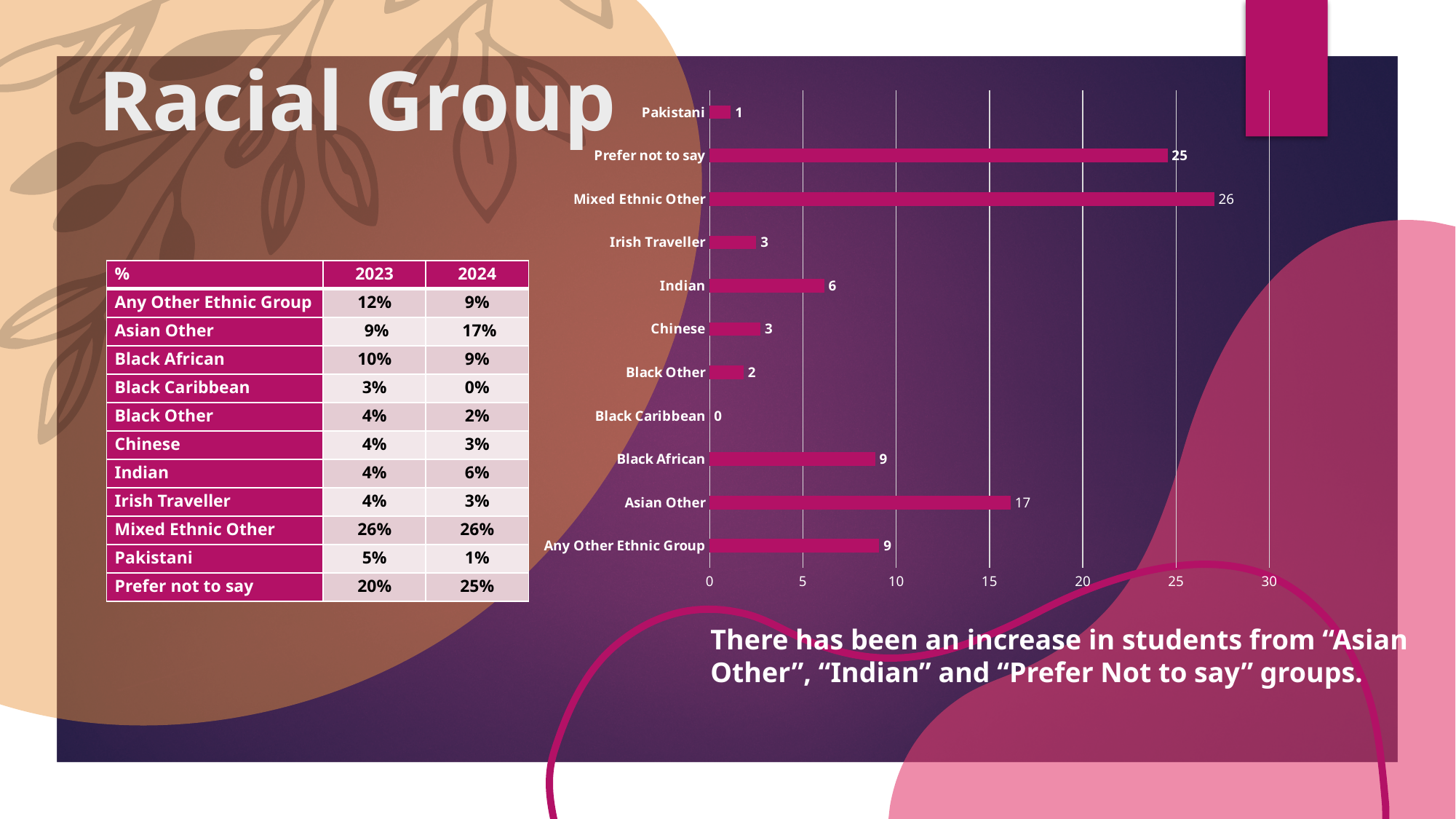
What is the difference between the values for Mixed Ethnic Other and Asian Other in the bar chart? 9 Is the value for Black African in the bar chart greater or less than 10? less What is the value for Mixed Ethnic Other in the bar chart? 26 What is the value for Pakistani in the bar chart? 1 Which is larger in the bar chart, the value for Indian or the value for Chinese? Indian What is the value for Prefer not to say in the bar chart? 25 What is the value for Asian Other in the bar chart? 17 What kind of chart is shown on the slide? bar chart Which category has the lowest value in the bar chart? Black Caribbean Which category has the highest value in the bar chart? Mixed Ethnic Other How many categories are shown in the bar chart? 11 What is the title of the slide containing the chart? Racial Group